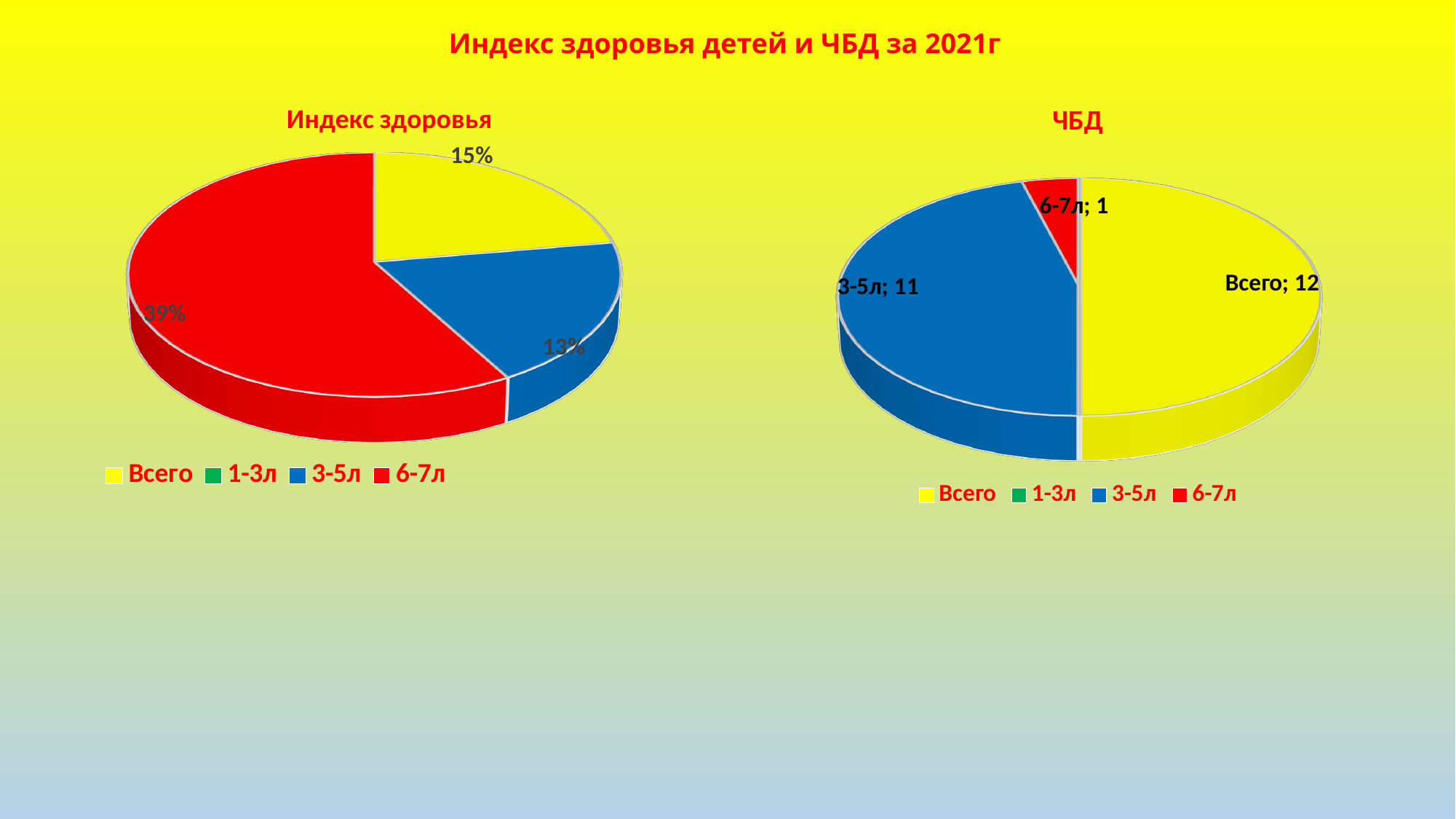
In the "ЧБД" chart, which is larger, the value for Всего or the value for 3-5л? Всего In the "Индекс здоровья" chart, what value is shown for the Всего slice? 15% In the "Индекс здоровья" chart, which labelled slice has the largest value? 6-7л What kind of chart is the "ЧБД" chart? Pie chart In the "ЧБД" chart, what value is shown for 6-7л? 1 In the "ЧБД" chart, what value is shown for 3-5л? 11 In the "ЧБД" chart, which labelled slice has the smallest value? 6-7л How many entries does the legend of the "Индекс здоровья" chart list? 4 In the "ЧБД" chart, what value is shown for Всего? 12 In the "Индекс здоровья" chart, what value is shown for the 6-7л slice? 39% In the "Индекс здоровья" chart, what value is shown for the 3-5л slice? 13% In the "Индекс здоровья" chart, what is the difference between the 6-7л value and the Всего value? 24%